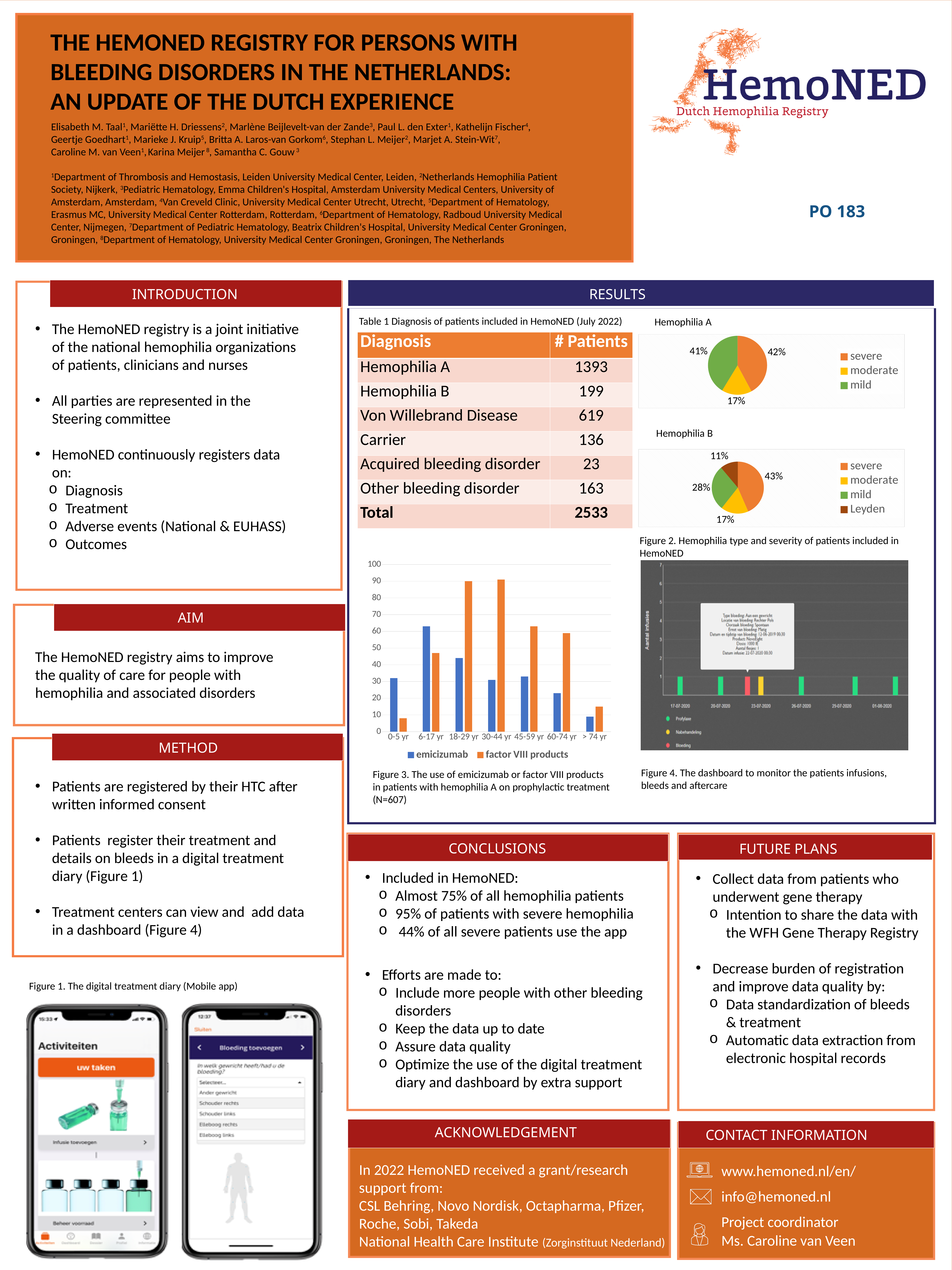
What kind of chart is used to show Hemophilia A severity? Pie chart In the Hemophilia B pie chart, what is the difference in percentage points between the severe and mild slices? 15 In the Figure 3 bar chart, for the 0-5 yr group, which is larger: emicizumab or factor VIII products? emicizumab In the Figure 3 bar chart, how many series does the legend list? 2 In the Hemophilia B pie chart, how many categories does the legend list? 4 In the Hemophilia B pie chart, what share of patients are Leyden? 11% In the Hemophilia A pie chart, what percentage of patients are moderate? 17% In the Hemophilia A pie chart, what share of patients are classified as severe? 42% In the Figure 3 bar chart, is the value for factor VIII products in the 18-29 yr group greater or less than 80? greater In the Figure 3 bar chart, how many age groups are shown on the x axis? 7 In the Figure 3 bar chart, which age group has the lowest factor VIII products bar? 0-5 yr In the Figure 3 bar chart, which age group has the highest emicizumab bar? 6-17 yr